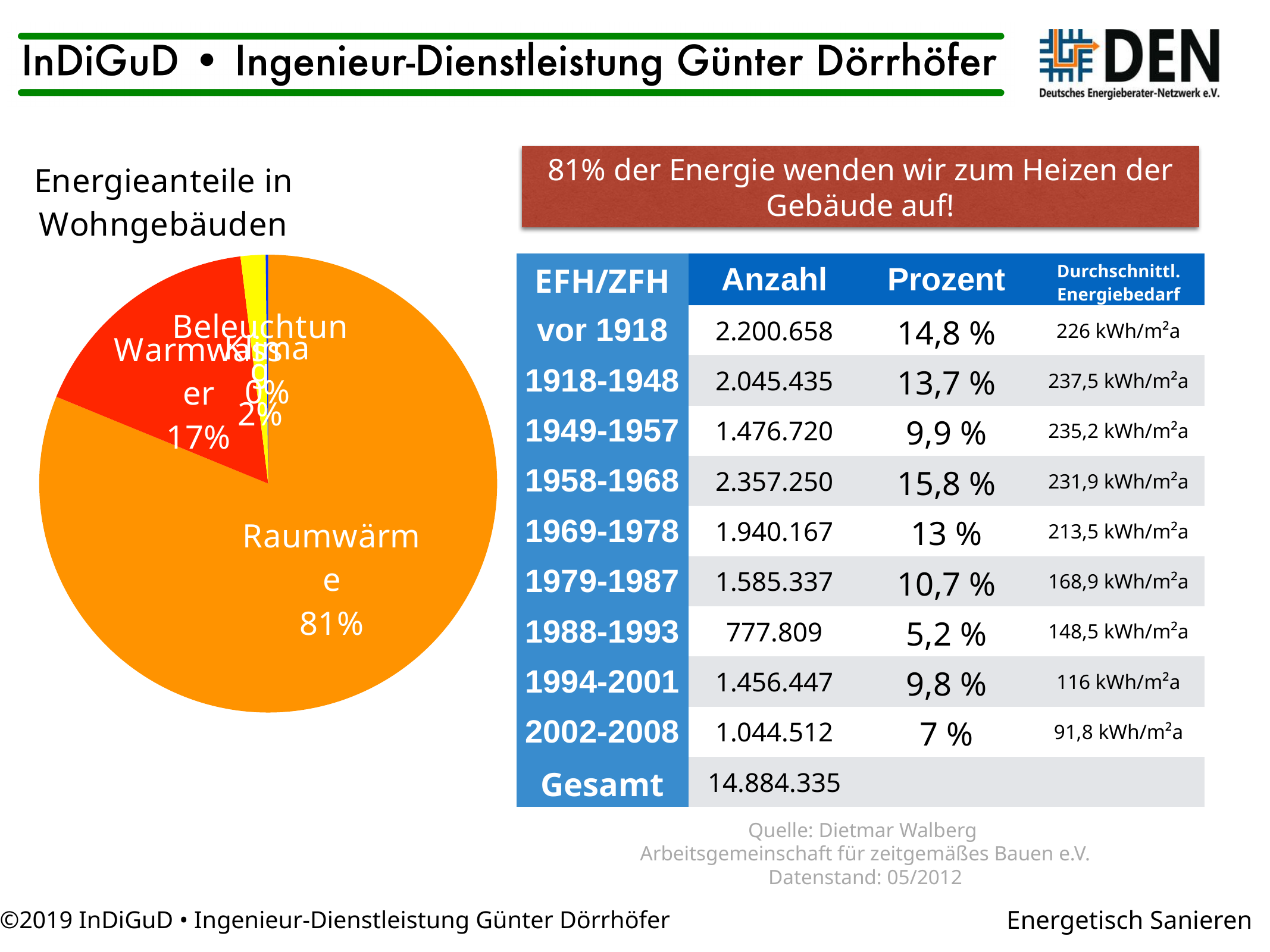
What colour is the Raumwärme slice in the pie chart? orange What share of the pie chart does Raumwärme have? 81% By how many percentage points does Raumwärme exceed Warmwasser in the pie chart? 64 Which slice of the pie chart is the largest? Raumwärme Which is larger in the pie chart, Raumwärme or Warmwasser? Raumwärme What share of the pie chart does Warmwasser have? 17% Which is larger in the pie chart, Warmwasser or Beleuchtung? Warmwasser What share of the pie chart does Beleuchtung have? 2% What is the title of the pie chart? Energieanteile in Wohngebäuden What kind of chart is shown on the left of the slide? pie chart By how many percentage points does Warmwasser exceed Beleuchtung in the pie chart? 15